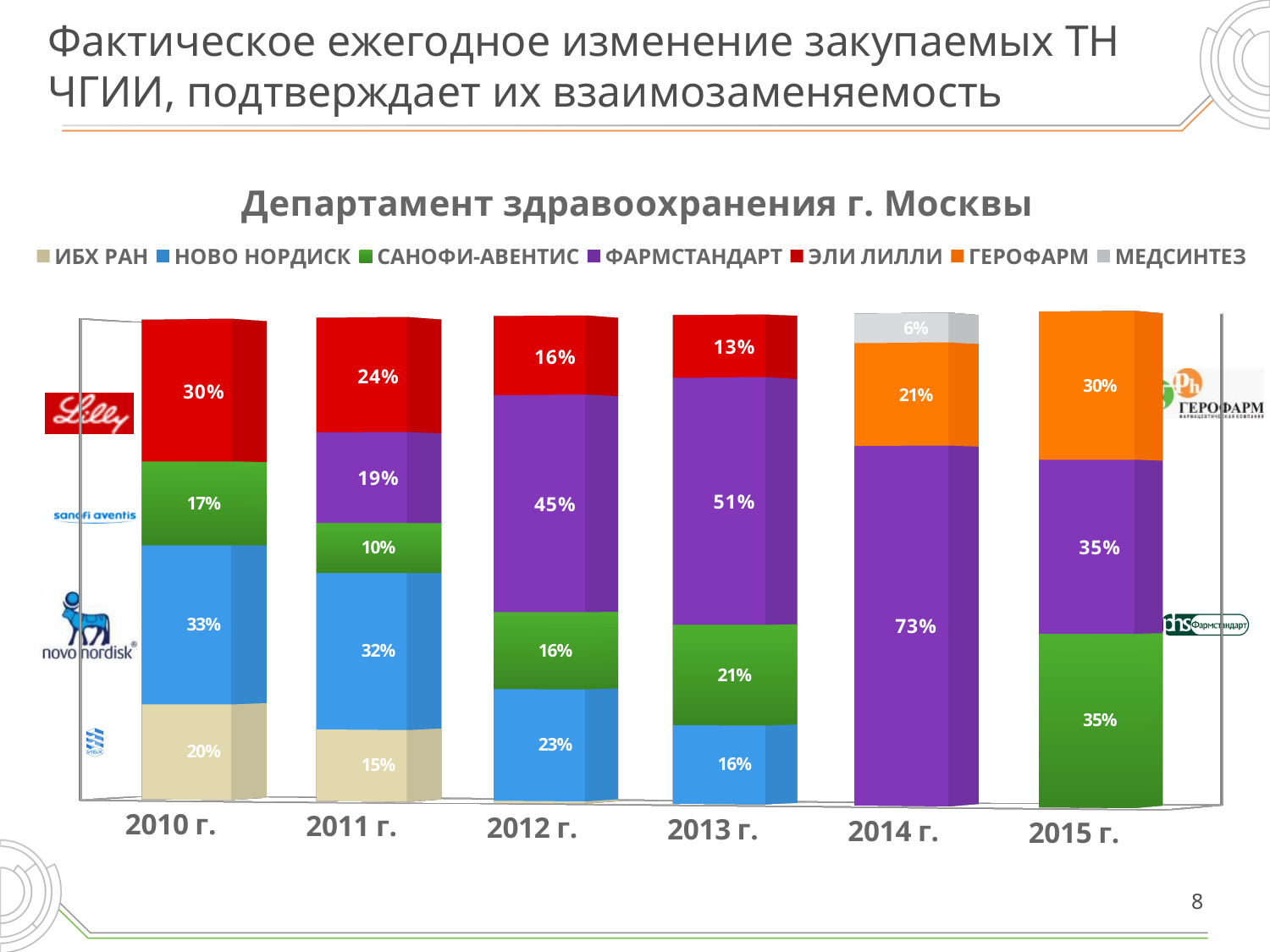
Does the ЭЛИ ЛИЛЛИ share rise or fall from 2010 г. to 2013 г.? Fall In which year is the ФАРМСТАНДАРТ share the highest? 2014 г. What is the share of ЭЛИ ЛИЛЛИ in 2010 г.? 30% What is the share of ФАРМСТАНДАРТ in 2014 г.? 73% In which year is the ЭЛИ ЛИЛЛИ share the lowest? 2013 г. What kind of chart is shown on the slide? Stacked bar chart What is the title of the chart? Департамент здравоохранения г. Москвы Which is larger in 2012 г.: the share of ФАРМСТАНДАРТ or the share of НОВО НОРДИСК? ФАРМСТАНДАРТ How many series does the legend list? 7 What is the difference between the НОВО НОРДИСК share in 2010 г. and in 2013 г.? 17% How many years are shown on the x axis? 6 What is the share of ГЕРОФАРМ in 2015 г.? 30%